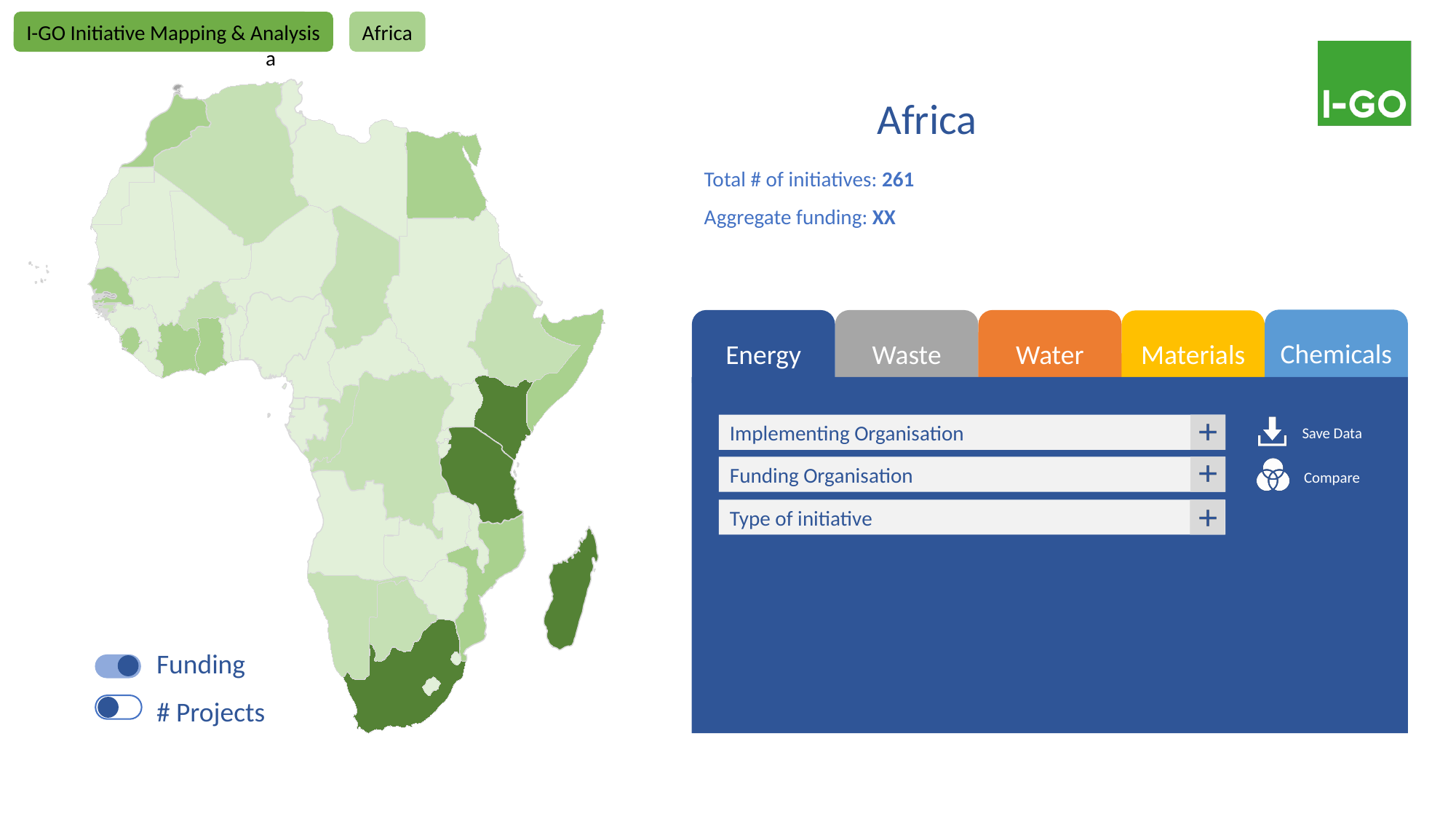
What kind of chart is shown on the left of the slide? A map (choropleth map of Africa) Which toggle is switched on below the map, Funding or # Projects? Funding What is the total number of initiatives shown for Africa? 261 What is the title shown above the dashboard panel on the right? Africa